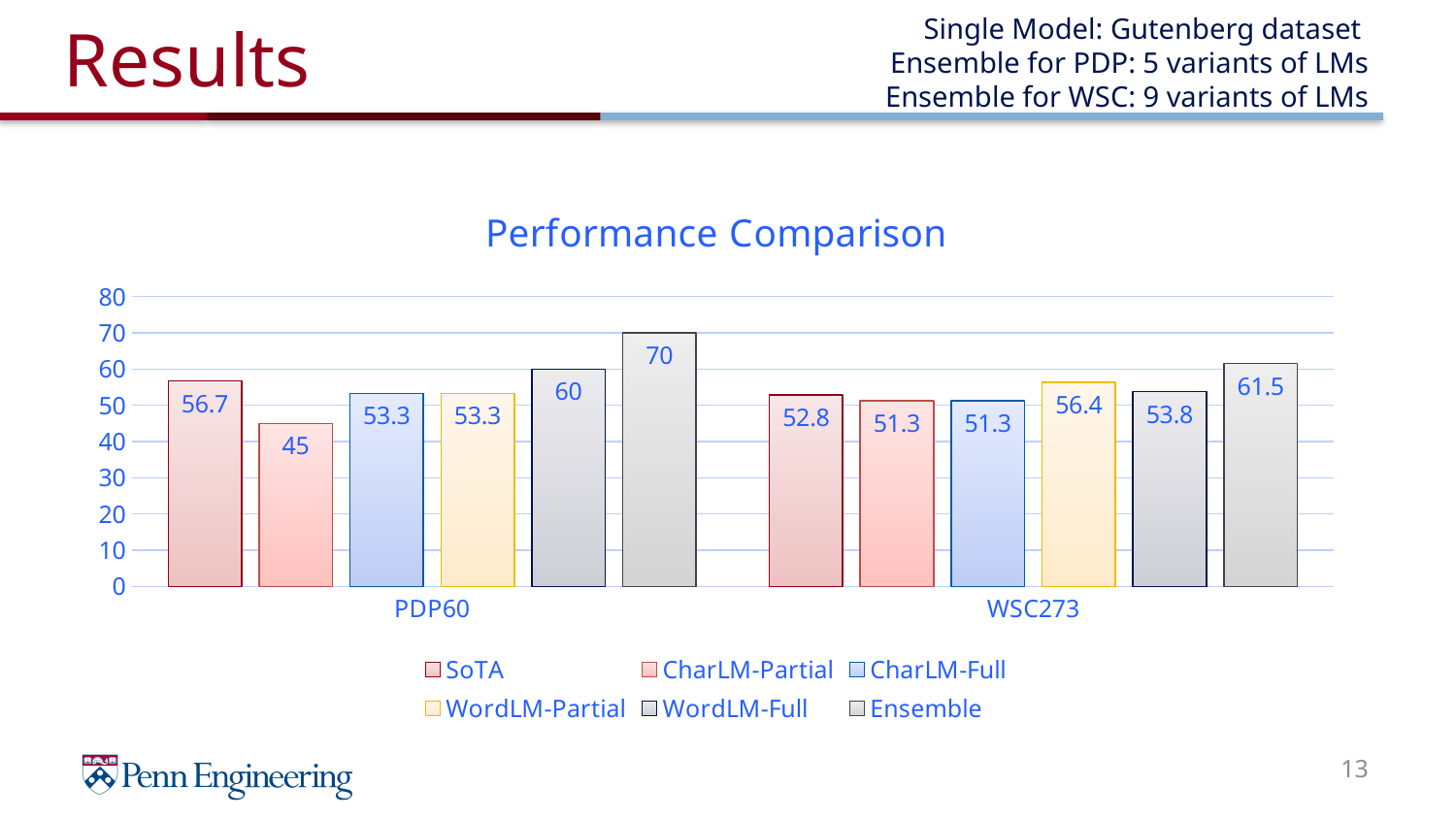
What is the value for SoTA on PDP60? 56.7 What kind of chart is shown? Bar chart What is the difference between the Ensemble and WordLM-Full values on PDP60? 10 What is the value for Ensemble on PDP60? 70 Which is larger on WSC273: WordLM-Partial or WordLM-Full? WordLM-Partial How many series does the legend list? 6 Which series has the lowest value on PDP60? CharLM-Partial How many categories are shown on the x axis? 2 Which series has the highest value on WSC273? Ensemble What is the difference between the Ensemble and SoTA values on WSC273? 8.7 What is the title of the chart? Performance Comparison What is the value for CharLM-Partial on WSC273? 51.3